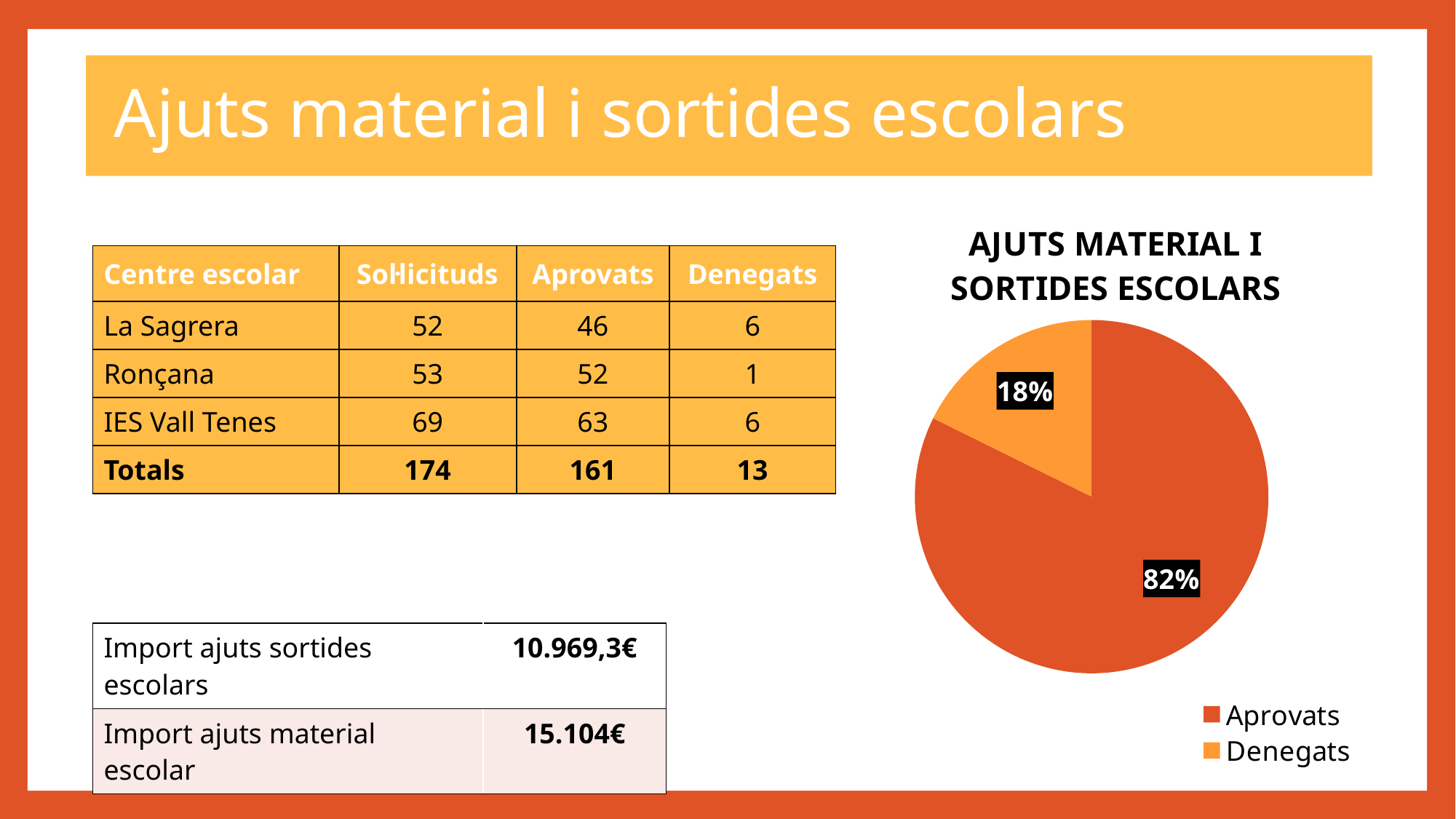
Which slice of the pie chart is the largest? Aprovats How many slices does the pie chart have? 2 What kind of chart is shown on the slide? pie chart Which is larger in the pie chart, Aprovats or Denegats? Aprovats What share of the pie chart is labelled Denegats? 18% What is the difference in percentage points between the Aprovats and Denegats slices? 64 What share of the pie chart is labelled Aprovats? 82% Which slice of the pie chart is the smallest? Denegats What is the title of the pie chart? AJUTS MATERIAL I SORTIDES ESCOLARS Which legend entry of the pie chart is shown in the lighter orange colour? Denegats How many entries does the pie chart's legend list? 2